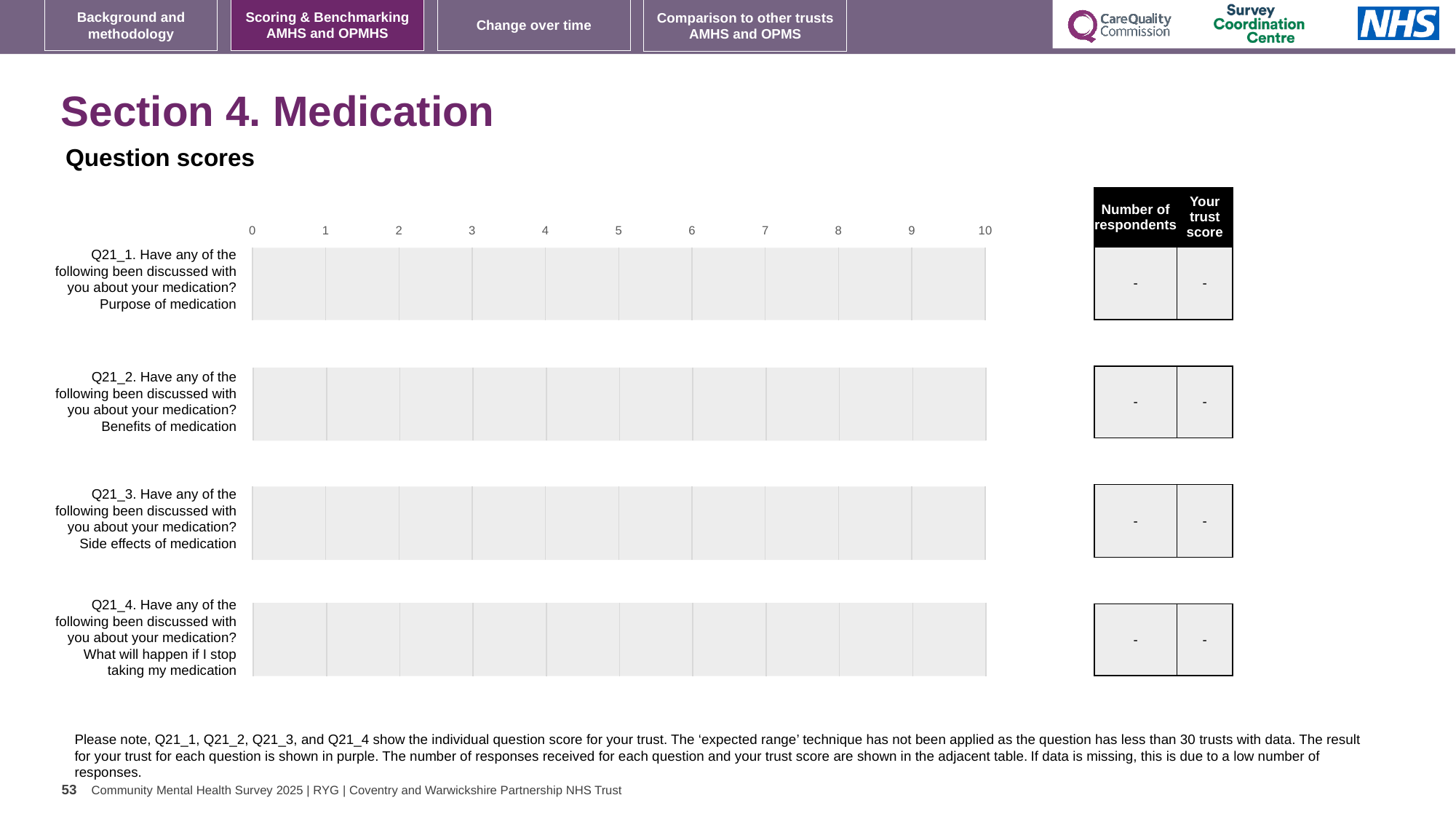
What heading appears directly above the chart? Question scores How many question categories are listed on the chart? 4 What is shown in the 'Your trust score' column for Q21_1 (Purpose of medication)? - What is shown in the 'Number of respondents' column for Q21_4 (What will happen if I stop taking my medication)? - What kind of chart is shown on the slide? bar chart What is the highest value shown on the chart's x axis? 10